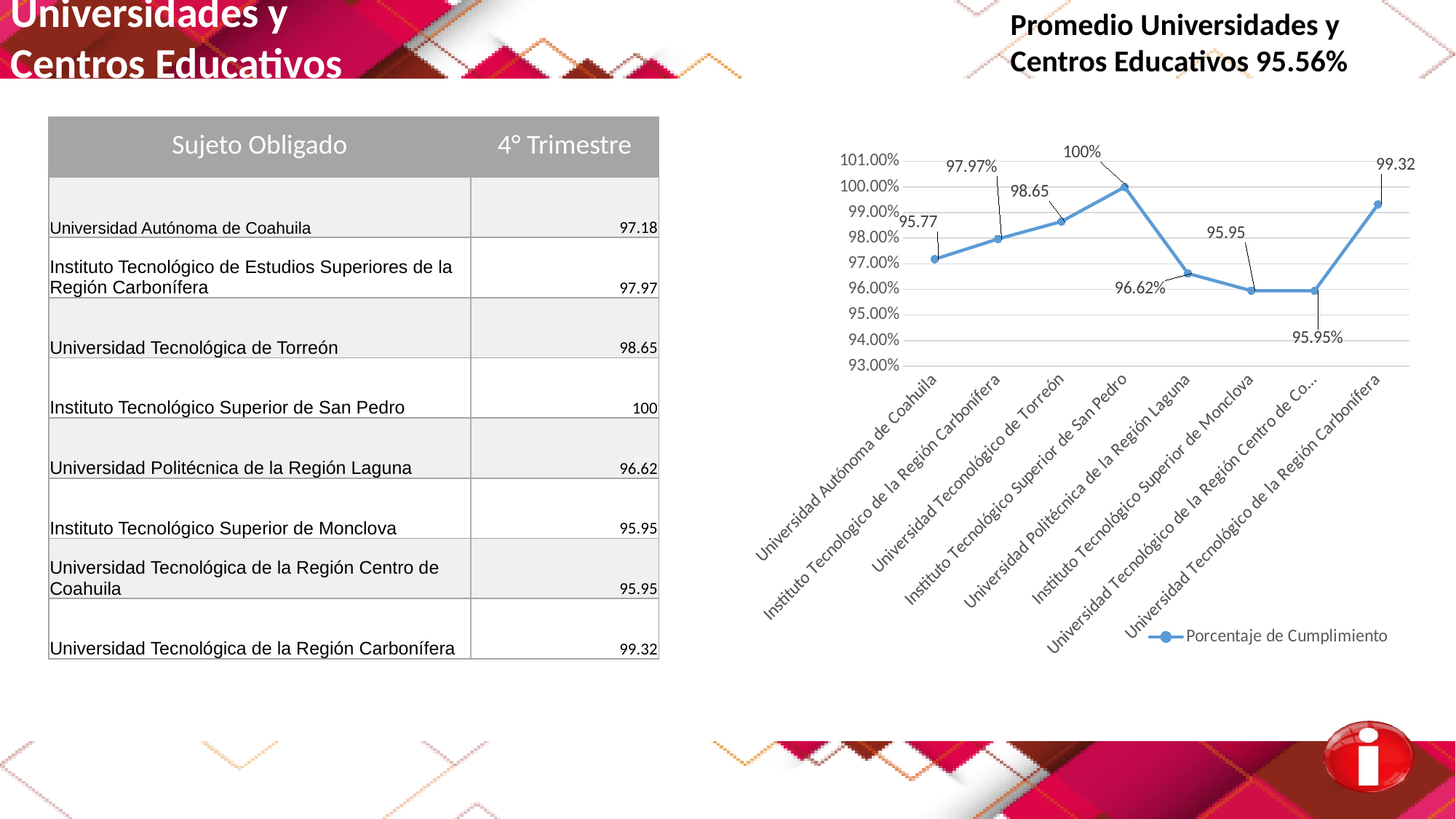
What is the name of the series shown in the chart legend? Porcentaje de Cumplimiento How many institutions are plotted along the x axis of the chart? 8 Which is larger, the value for Universidad Tecnológica de Torreón or the value for Universidad Politécnica de la Región Laguna? Universidad Tecnológica de Torreón What is the value labelled for Universidad Politécnica de la Región Laguna? 96.62% How many series does the chart legend list? 1 What is the value labelled for Instituto Tecnológico Superior de San Pedro? 100% Does the line rise or fall from Instituto Tecnológico Superior de San Pedro to Universidad Politécnica de la Región Laguna? fall Is the value for Universidad Politécnica de la Región Laguna greater or less than 97.00%? less Which institution has the highest value in the chart? Instituto Tecnológico Superior de San Pedro What is the value labelled for Universidad Tecnológica de la Región Carbonífera? 99.32 What is the value labelled for Universidad Tecnológica de Torreón? 98.65 What kind of chart is shown on the slide? line chart